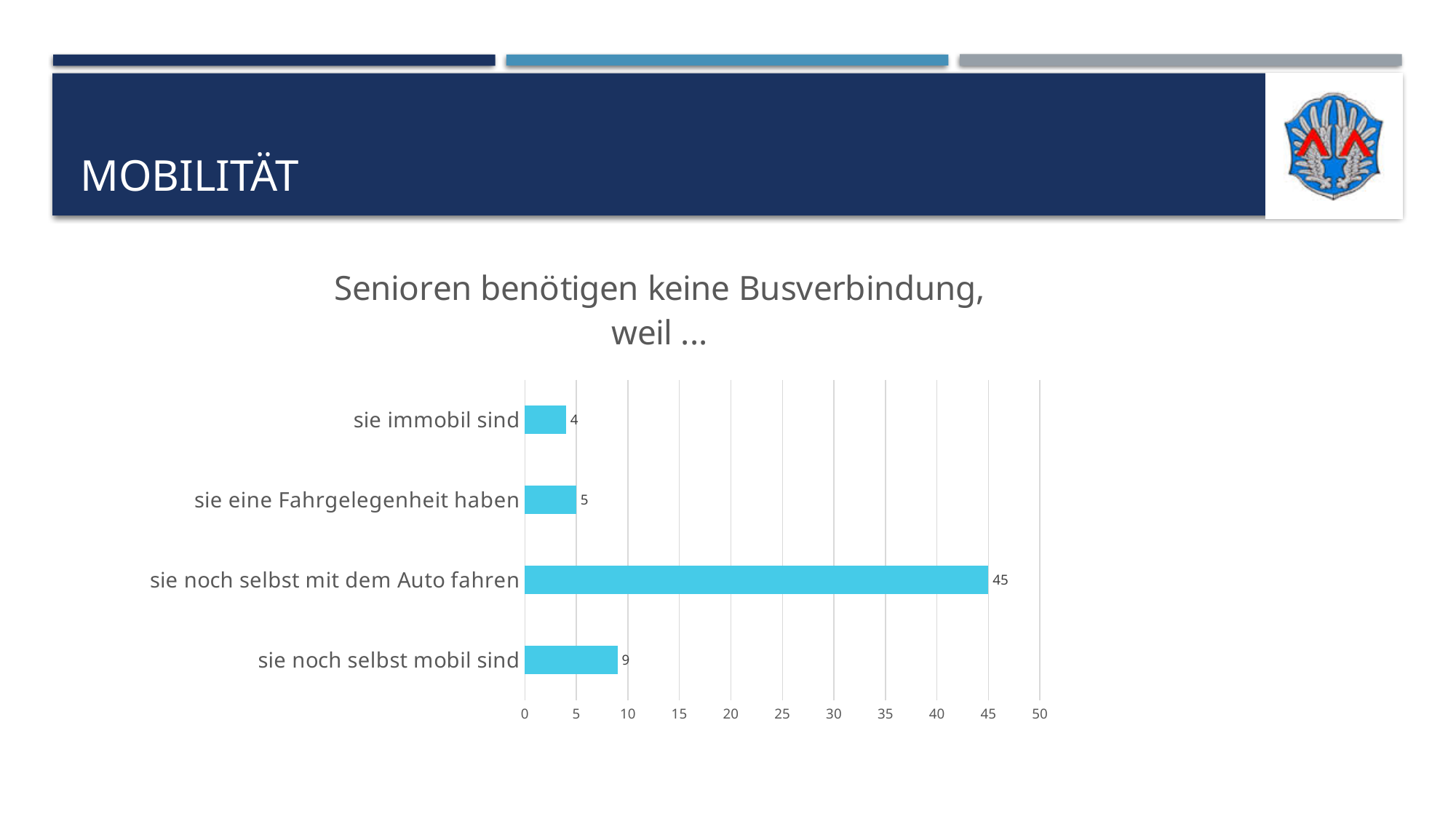
What is the value for "sie immobil sind"? 4 What is the difference between the values for "sie noch selbst mit dem Auto fahren" and "sie noch selbst mobil sind"? 36 What is the title of the chart? Senioren benötigen keine Busverbindung, weil ... What is the value for "sie noch selbst mobil sind"? 9 Which is larger: the value for "sie noch selbst mobil sind" or "sie eine Fahrgelegenheit haben"? sie noch selbst mobil sind What is the value for "sie noch selbst mit dem Auto fahren"? 45 How many categories are shown in the chart? 4 What is the value for "sie eine Fahrgelegenheit haben"? 5 Which category has the highest value? sie noch selbst mit dem Auto fahren What kind of chart is shown on the slide? bar chart Is the value for "sie noch selbst mit dem Auto fahren" greater or less than 40? greater Which category has the lowest value? sie immobil sind